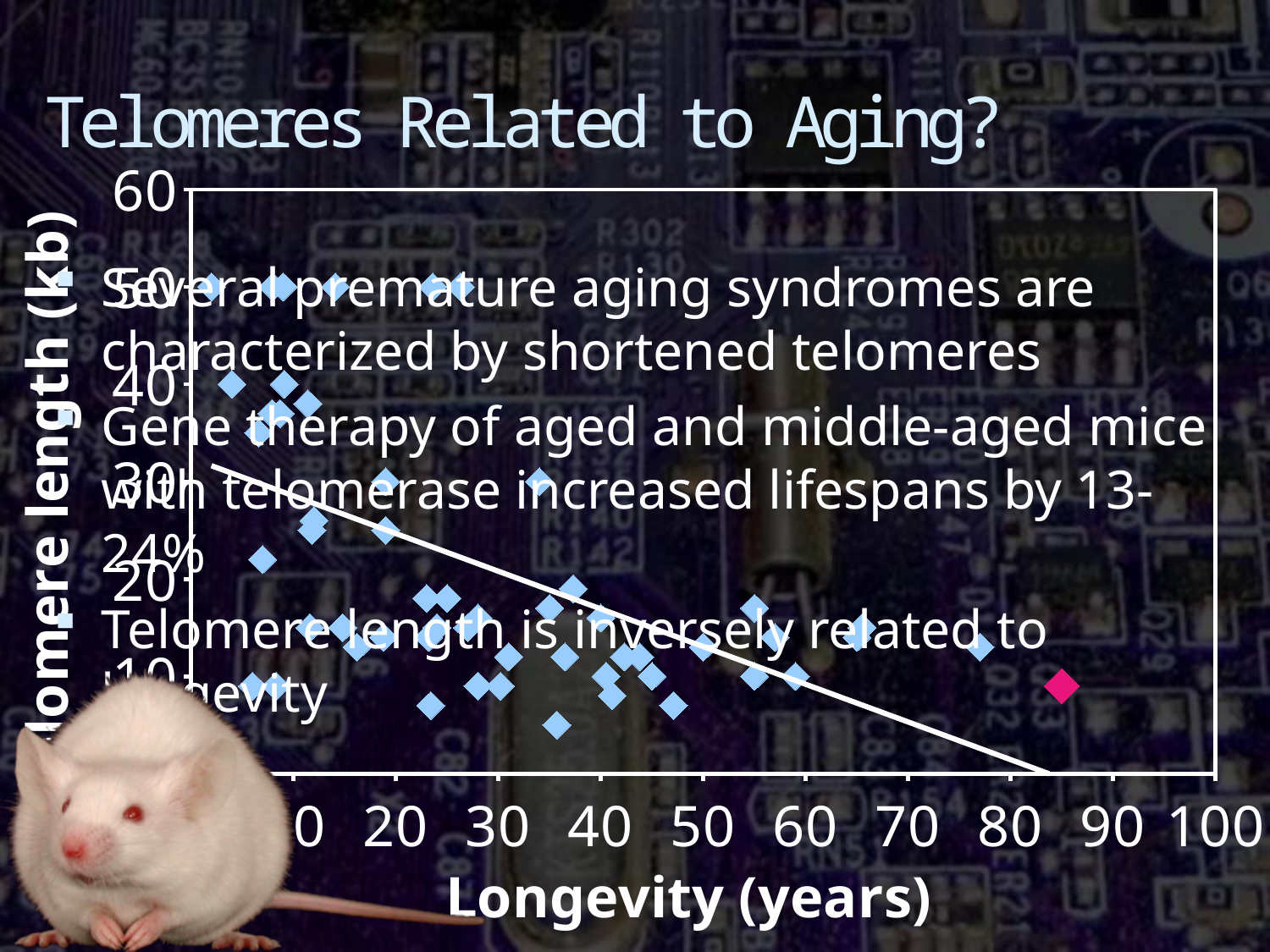
What is the label of the x axis of the chart? Longevity (years) What kind of chart is shown on the slide? scatter plot Is the telomere length of the magenta (pink) point near 85 years greater or less than 20 kb? less What is the highest value shown on the x axis of the chart? 100 Is the telomere length of the lowest point near 35 years of longevity greater or less than 20 kb? less What is the highest tick value shown on the y axis of the chart? 60 Do telomere length values generally rise or fall as longevity increases along the x axis? fall Is the telomere length of the magenta (pink) point near 85 years greater or less than 30 kb? less